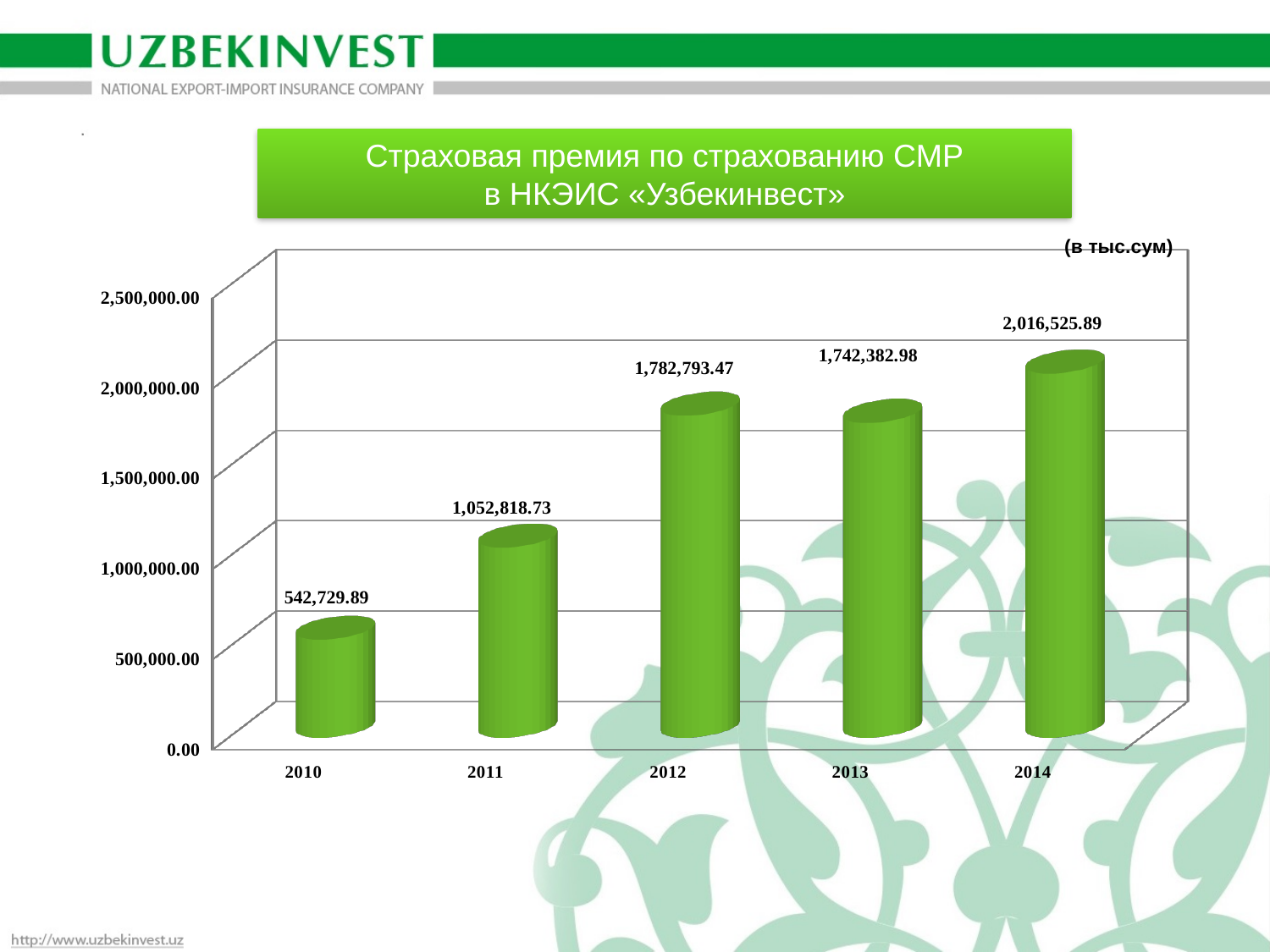
How many years are shown on the x axis? 5 What is the value shown for 2010? 542,729.89 Which year has the highest value? 2014 Is the value for 2011 greater or less than 1,000,000.00? greater By how much did the value increase from 2010 to 2011? 510,088.84 What is the value shown for 2012? 1,782,793.47 Which year has the larger value, 2012 or 2013? 2012 What is the difference between the 2014 and 2013 values? 274,142.91 Which year has the lowest value? 2010 Does the value rise or fall from 2012 to 2013? Fall What is the insurance premium value for 2014? 2,016,525.89 What kind of chart is shown on the slide? Bar chart